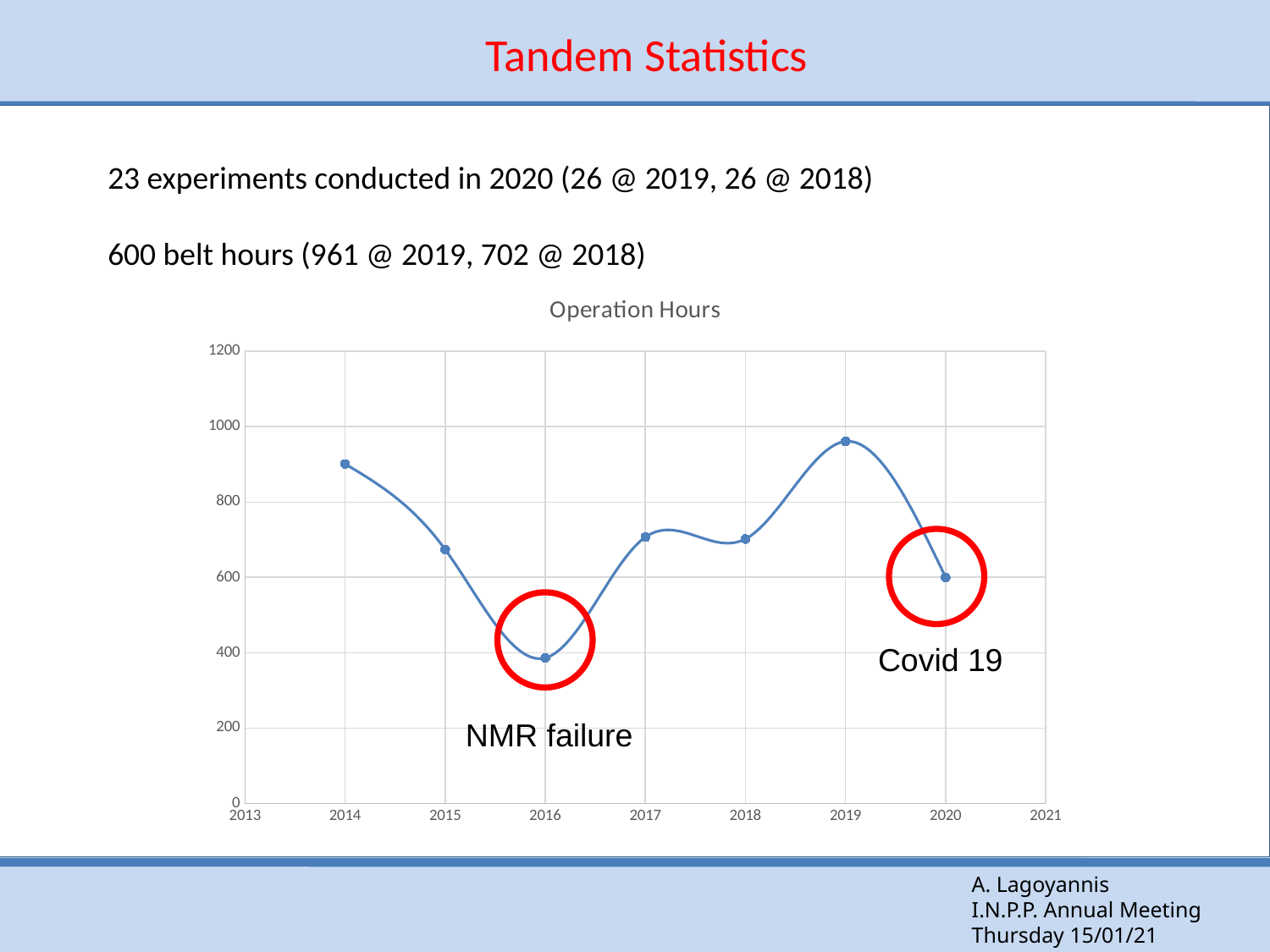
What kind of chart is shown on the slide? line chart Do the operation hours rise or fall from 2019 to 2020? fall Is the value for 2014 greater or less than 800? greater Which year has the lowest operation hours? 2016 How many data points are plotted on the Operation Hours chart? 7 Which event is annotated next to the circled 2016 point on the chart? NMR failure Which year has the larger value, 2014 or 2015? 2014 Which year has the highest operation hours? 2019 What is the title of the chart? Operation Hours Is the value for 2016 greater or less than 600? less What is the value for 2020 on the Operation Hours chart? 600 Is the value for 2019 greater or less than 1000? less